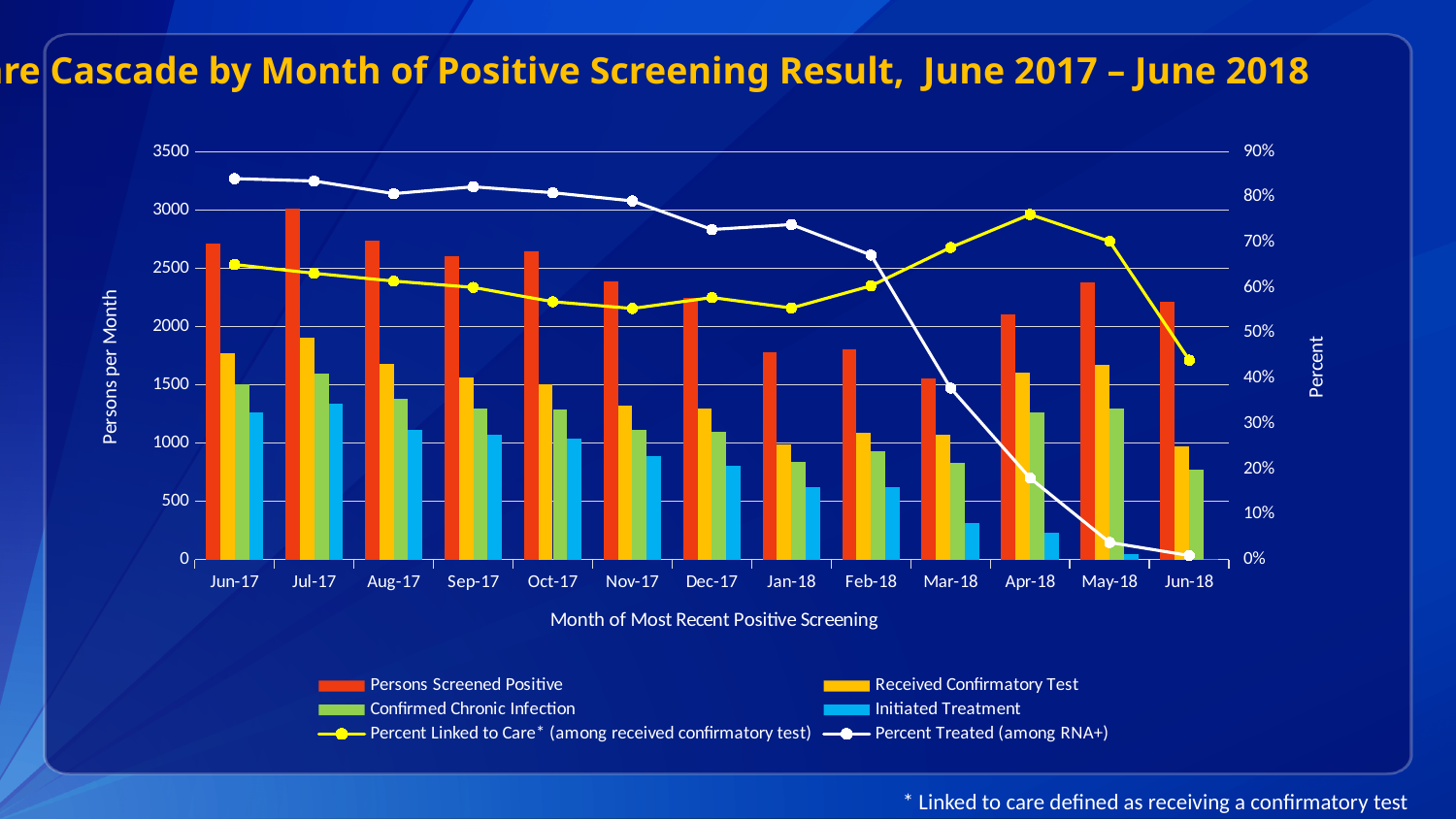
In which month does the Percent Linked to Care line reach its highest point? Apr-18 How many series does the chart's legend list? 6 Does the Percent Treated line generally rise or fall from Jun-17 to Jun-18? fall In which month is the Persons Screened Positive bar lowest? Mar-18 How many months are shown on the x axis of the chart? 13 Is the Percent Treated value in Apr-18 greater or less than 30%? less Is the value for Persons Screened Positive in Jul-17 greater or less than 2500? greater What kind of chart is shown on the slide? A combination bar and line chart Is the Percent Treated value in Jun-17 greater or less than 80%? greater In which month is the Percent Treated line at its lowest? Jun-18 Which month has the larger Initiated Treatment bar, Jun-17 or Jun-18? Jun-17 In which month is the Persons Screened Positive bar highest? Jul-17